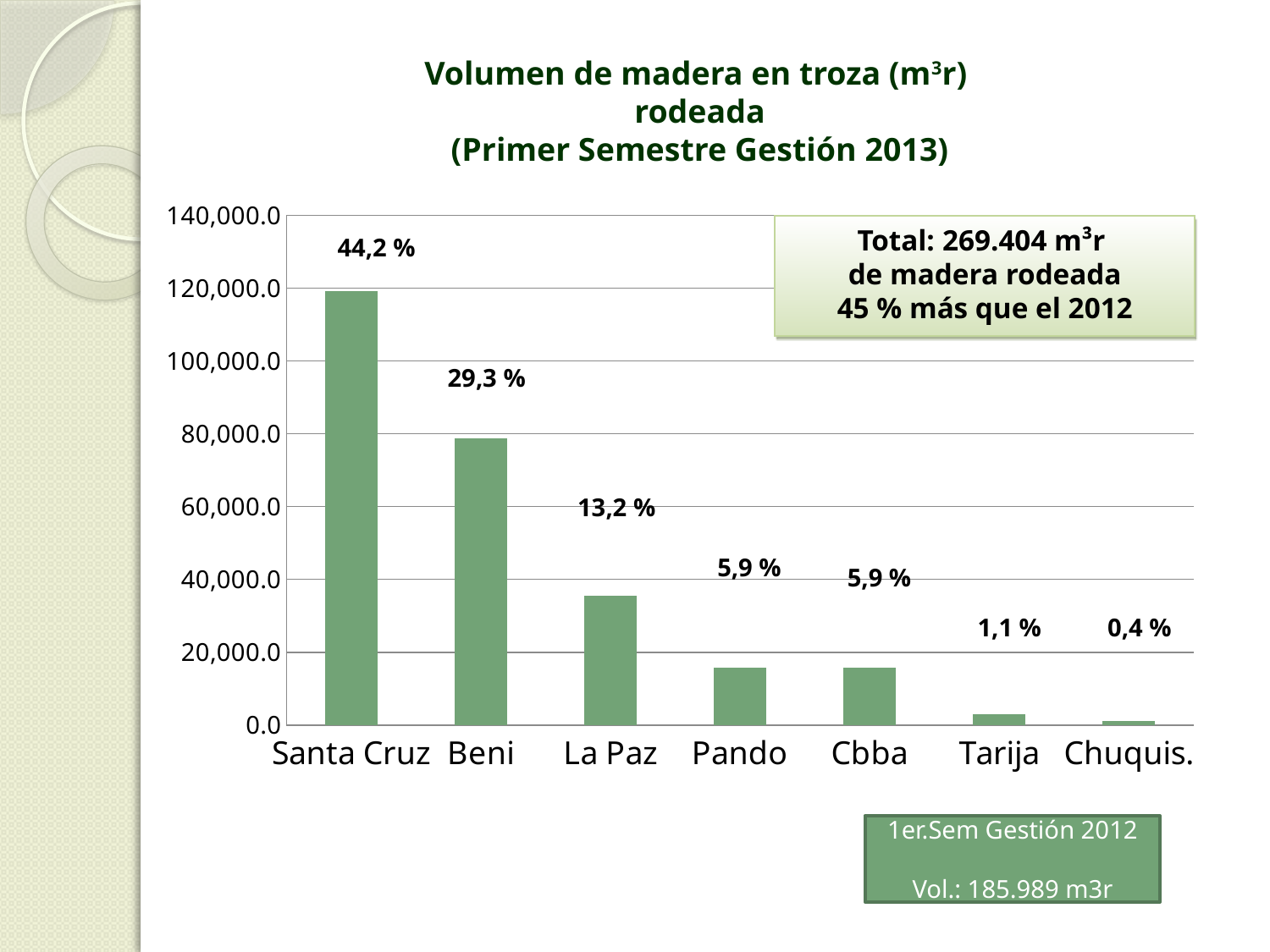
What percentage share is labelled above the La Paz bar? 13,2 % What percentage share is labelled above the Beni bar? 29,3 % What kind of chart is shown on the slide? bar chart What percentage share is labelled above the Santa Cruz bar? 44,2 % Which department has the lowest volume of wood in the chart? Chuquis. Do the bar values rise or fall moving from left to right along the x axis? fall Is the value for Santa Cruz greater or less than 100,000.0? greater What percentage share is labelled above the Tarija bar? 1,1 % How many departments (categories) are shown on the x axis of the chart? 7 Which is larger, the value for Beni or the value for La Paz? Beni Which department has the highest volume of wood in the chart? Santa Cruz